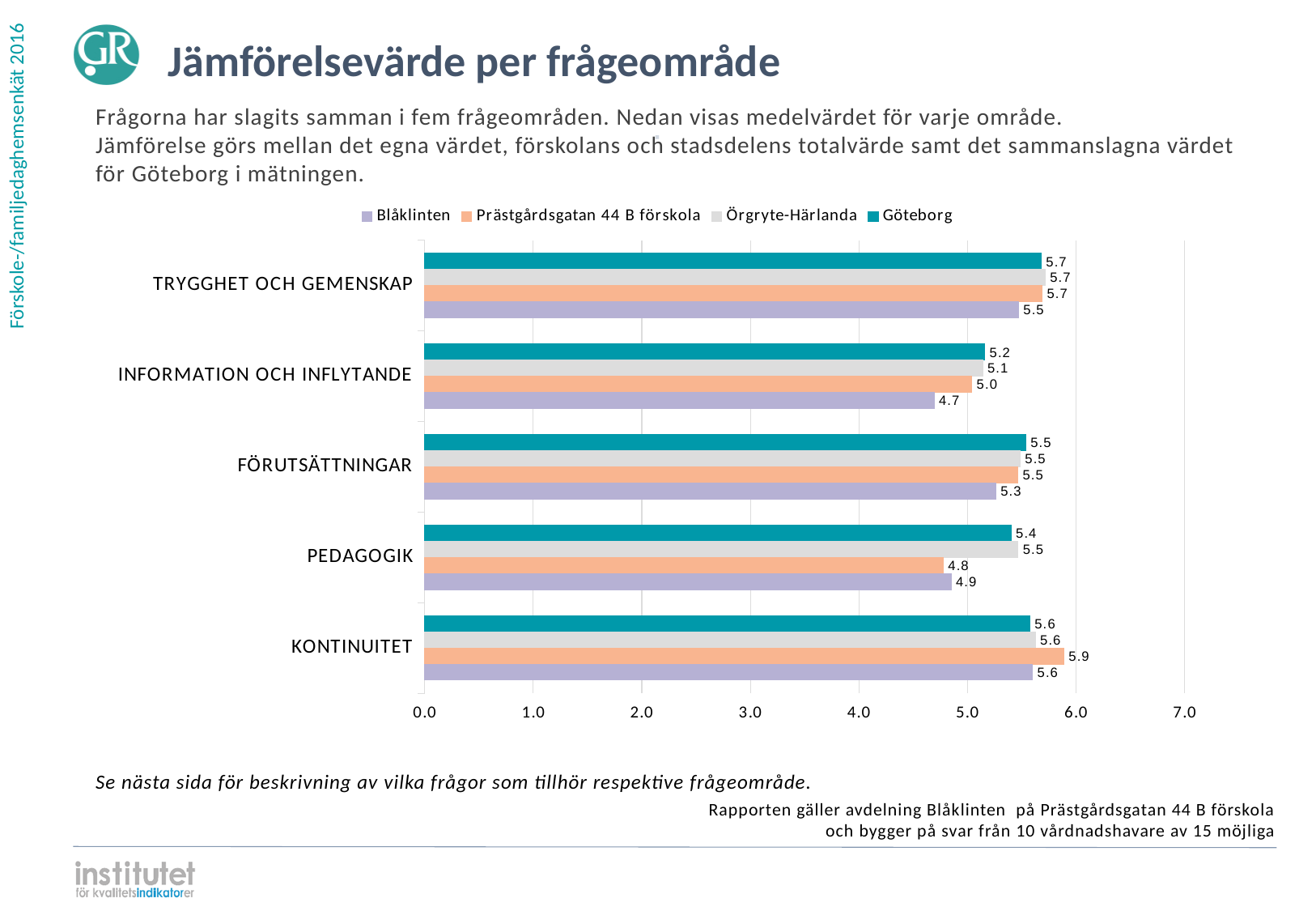
What is the difference between the Göteborg value and the Blåklinten value in the INFORMATION OCH INFLYTANDE category? 0.5 What is the value for Örgryte-Härlanda in the FÖRUTSÄTTNINGAR category? 5.5 In which category does Prästgårdsgatan 44 B förskola have its highest value? KONTINUITET How many series does the legend list? 4 How many question areas (categories) are shown on the chart? 5 In the PEDAGOGIK category, which is larger: the value for Blåklinten or the value for Prästgårdsgatan 44 B förskola? Blåklinten In which category does Blåklinten have its lowest value? INFORMATION OCH INFLYTANDE Which series is shown in teal on the chart? Göteborg What is the value for Göteborg in the PEDAGOGIK category? 5.4 What is the value for Prästgårdsgatan 44 B förskola in the KONTINUITET category? 5.9 What kind of chart is shown on the slide? Bar chart What is the value for Blåklinten in the INFORMATION OCH INFLYTANDE category? 4.7